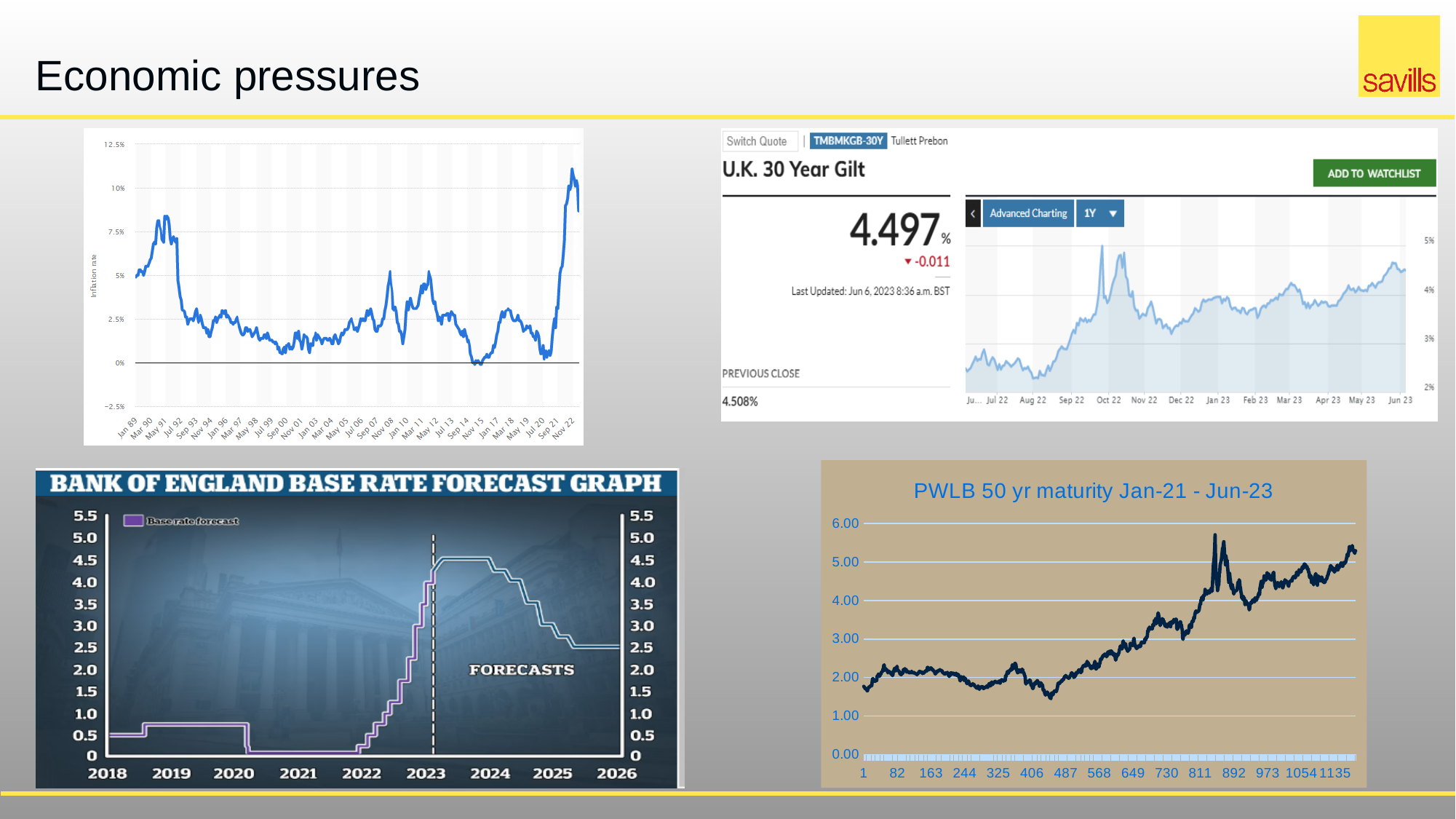
On the Bank of England base rate forecast graph, is the forecast value for 2026 greater or less than 3.0? less On the Bank of England base rate forecast graph, what series does the legend list? Base rate forecast What is the title of the chart in the bottom right of the slide? PWLB 50 yr maturity Jan-21 - Jun-23 On the U.K. 30 Year Gilt chart, what change in value is shown next to the current yield? -0.011 On the U.K. 30 Year Gilt chart, what is the current yield value shown? 4.497% On the PWLB 50 yr maturity chart, do the values generally rise or fall from left to right? rise On the inflation rate chart in the top left, is the value around Nov 15 greater or less than 2.5%? less On the U.K. 30 Year Gilt chart, what is the previous close value? 4.508% On the PWLB 50 yr maturity chart, is the final value at the right end greater or less than 5.00? greater What kind of chart is the PWLB 50 yr maturity chart in the bottom right? line chart